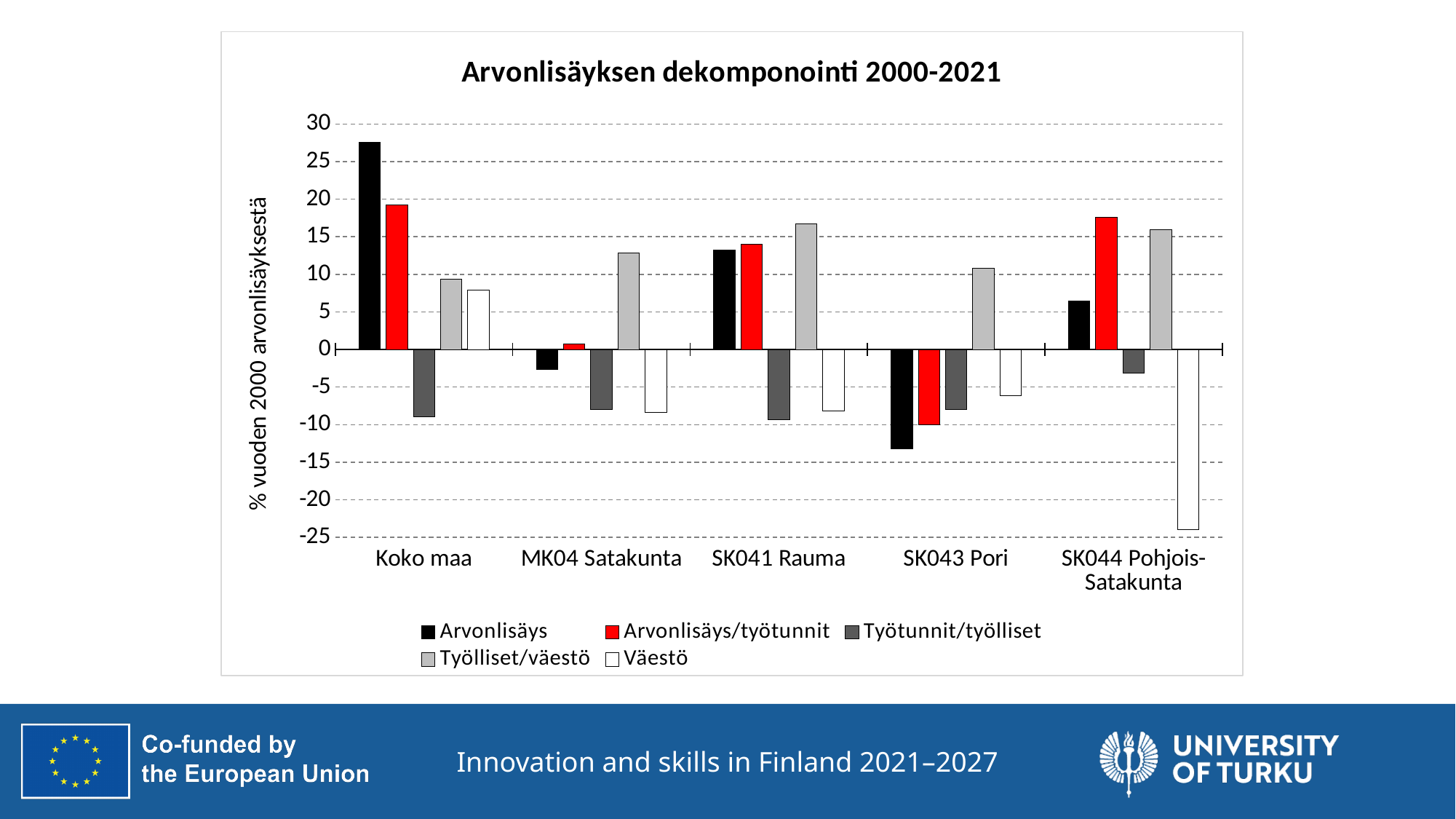
Is the Arvonlisäys value for SK043 Pori greater or less than -10? less Is the Arvonlisäys value for Koko maa greater or less than 25? greater Is the Väestö value for SK044 Pohjois-Satakunta greater or less than -20? less Which region has the lowest Arvonlisäys/työtunnit value? SK043 Pori Which region has the lowest Arvonlisäys value? SK043 Pori What is the title of the chart? Arvonlisäyksen dekomponointi 2000-2021 What kind of chart is shown on the slide? bar chart Which region has the highest Arvonlisäys value? Koko maa How many series does the legend list? 5 Which region has the lowest Väestö value? SK044 Pohjois-Satakunta How many regions (categories) are shown on the x axis? 5 Which is larger, the Työlliset/väestö value for SK041 Rauma or for Koko maa? SK041 Rauma